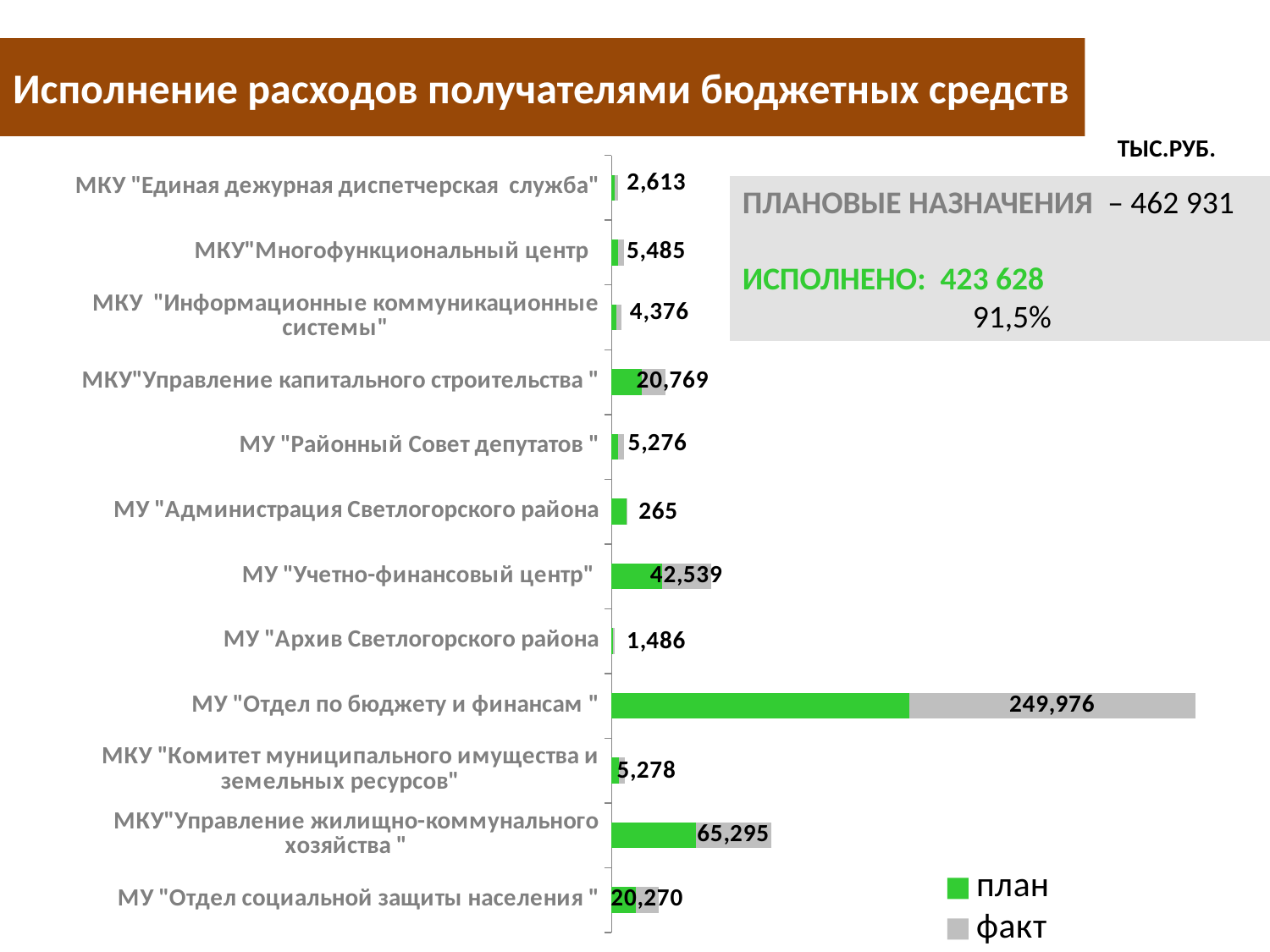
What value is labelled for МКУ "Управление жилищно-коммунального хозяйства"? 65,295 Which has the larger labelled value: МУ "Учетно-финансовый центр" or МКУ "Управление капитального строительства"? МУ "Учетно-финансовый центр" What value is labelled for МУ "Отдел по бюджету и финансам"? 249,976 What is the difference between the labelled values for МКУ "Управление жилищно-коммунального хозяйства" and МУ "Учетно-финансовый центр"? 22,756 Which category has the highest labelled value on the chart? МУ "Отдел по бюджету и финансам" What value is labelled for МУ "Архив Светлогорского района"? 1,486 How many categories (budget recipients) are listed on the chart? 12 How many series does the chart legend list? 2 Which category has the lowest labelled value on the chart? МУ "Администрация Светлогорского района" What are the two series named in the chart legend? план and факт What value is labelled for МУ "Учетно-финансовый центр"? 42,539 What kind of chart is shown on the slide? bar chart